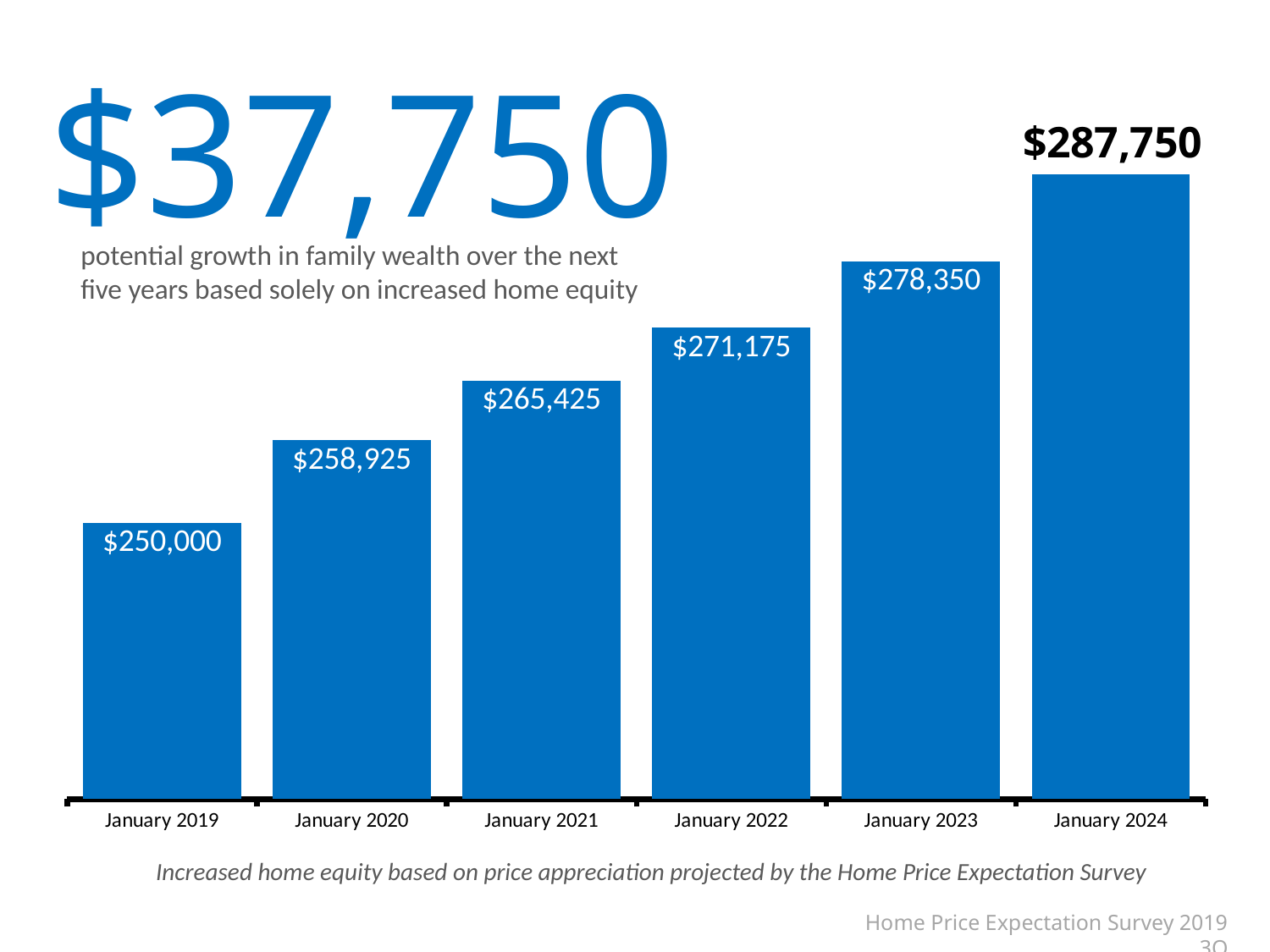
What is the value for January 2019? $250,000 What is the difference between the values for January 2024 and January 2019? $37,750 How many categories are shown on the x axis? 6 Do the values rise or fall from January 2019 to January 2024? Rise What is the value for January 2021? $265,425 Which is larger, the value for January 2022 or the value for January 2020? January 2022 What kind of chart is shown on the slide? Bar chart What is the difference between the values for January 2020 and January 2019? $8,925 What is the value for January 2023? $278,350 Which category has the lowest value? January 2019 What is the value for January 2024? $287,750 Which category has the highest value? January 2024